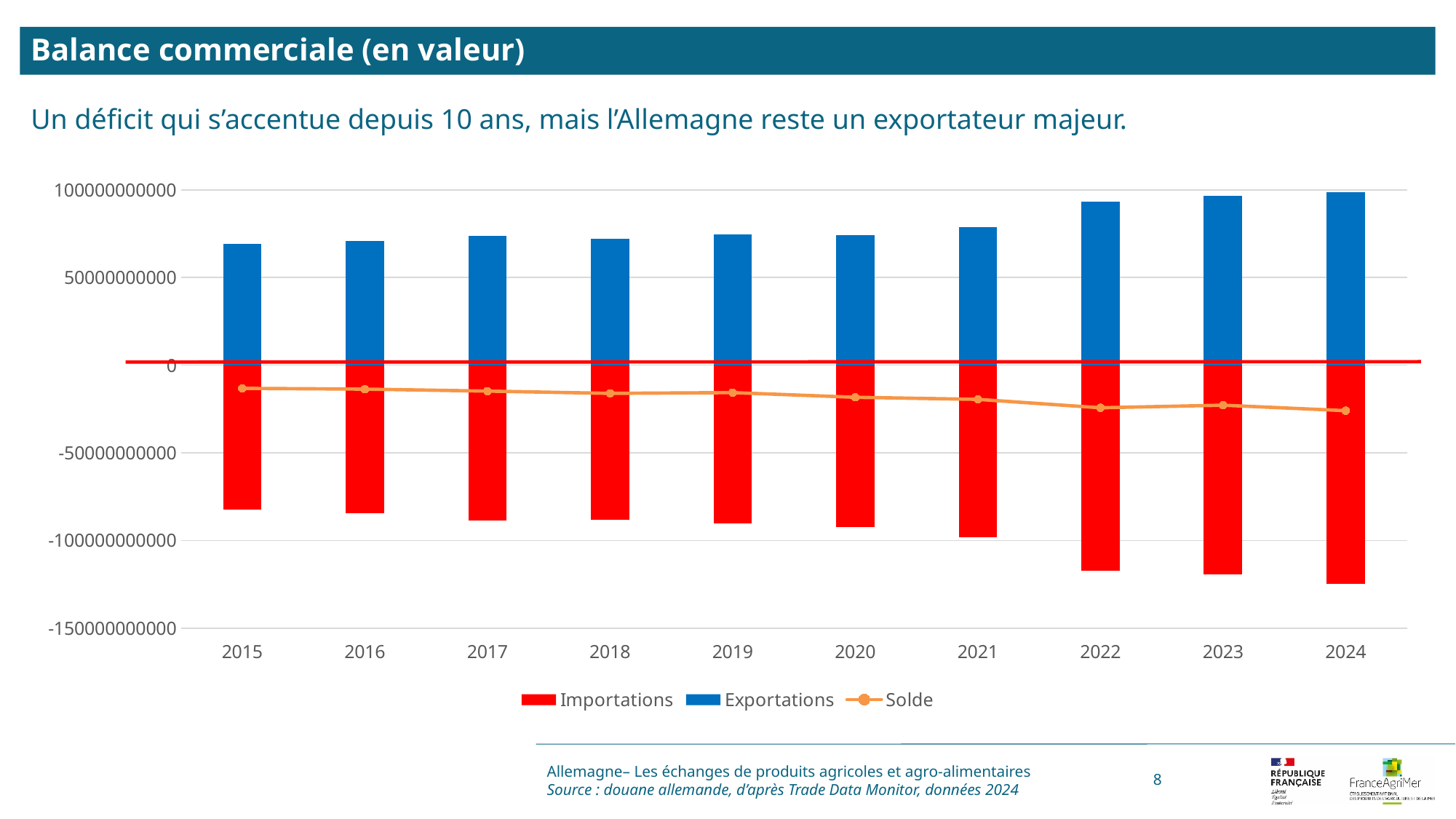
Is the Exportations value for 2024 greater or less than 50000000000? greater Which year has the highest Exportations value? 2024 Which is larger, the Exportations value for 2022 or for 2019? 2022 Is the Importations value for 2015 greater or less than -100000000000? greater How many series does the chart legend list? 3 Does the Solde line rise or fall from 2015 to 2024? fall Which colour represents Importations in the chart? red Is the Importations value for 2024 greater or less than -100000000000? less Which year has the most negative Importations value? 2024 How many years are shown on the x axis of the chart? 10 What kind of chart is shown on the slide? bar chart with a line